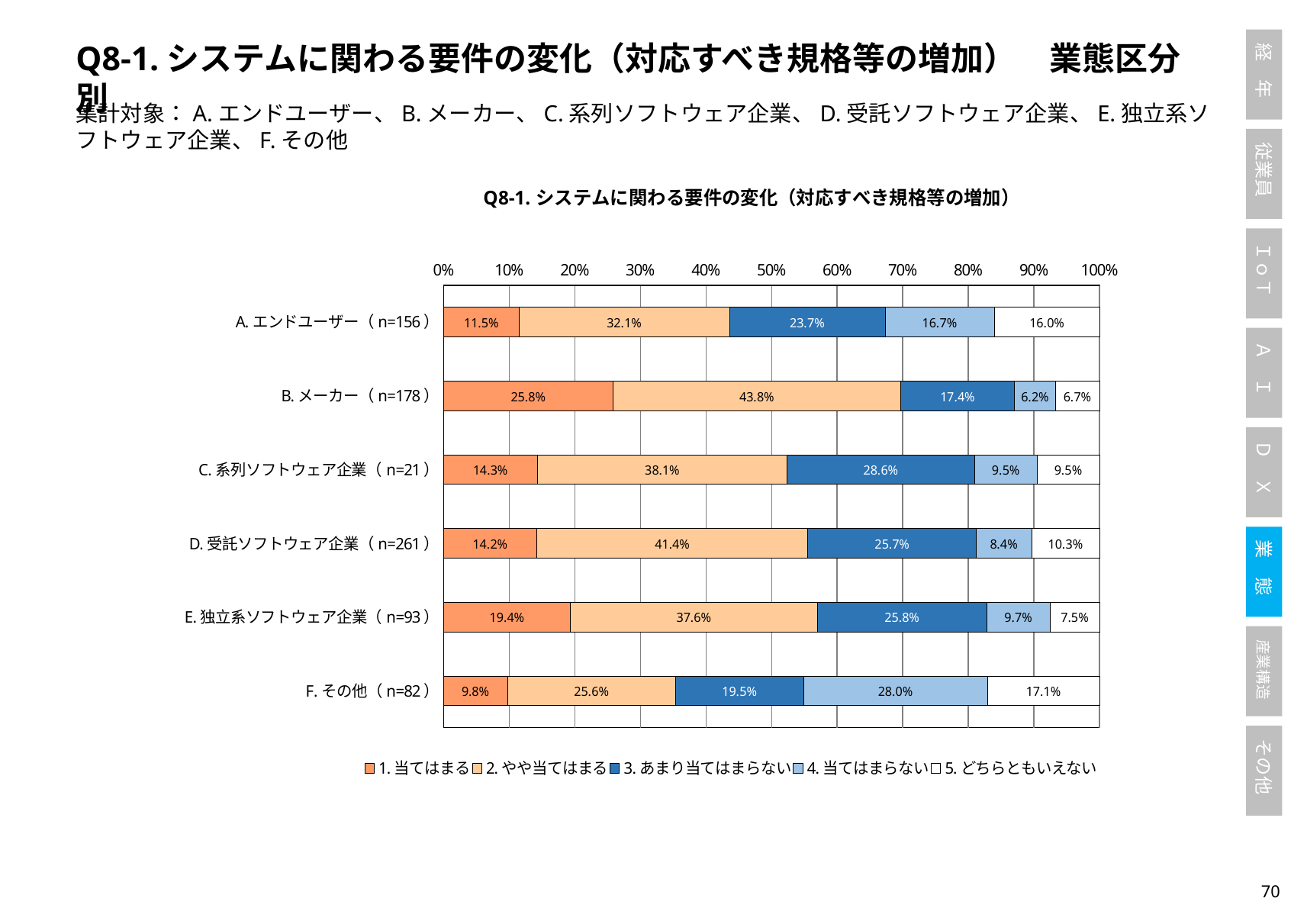
Which category has the highest value for "2. やや当てはまる"? B. メーカー What type of chart is shown on the slide? Stacked bar chart Which has the larger "3. あまり当てはまらない" value: C. 系列ソフトウェア企業 or D. 受託ソフトウェア企業? C. 系列ソフトウェア企業 What is the sample size (n) shown for D. 受託ソフトウェア企業? n=261 How many business categories (bars) are plotted in the chart? 6 What is the value of "4. 当てはまらない" for F. その他? 28.0% What is the difference between the "2. やや当てはまる" values for B. メーカー and A. エンドユーザー? 11.7 percentage points What is the value of "1. 当てはまる" for B. メーカー? 25.8% Which category has the lowest value for "1. 当てはまる"? F. その他 What is the combined value of "1. 当てはまる" and "2. やや当てはまる" for B. メーカー? 69.6% What is the value of "3. あまり当てはまらない" for A. エンドユーザー? 23.7% How many series does the legend list? 5